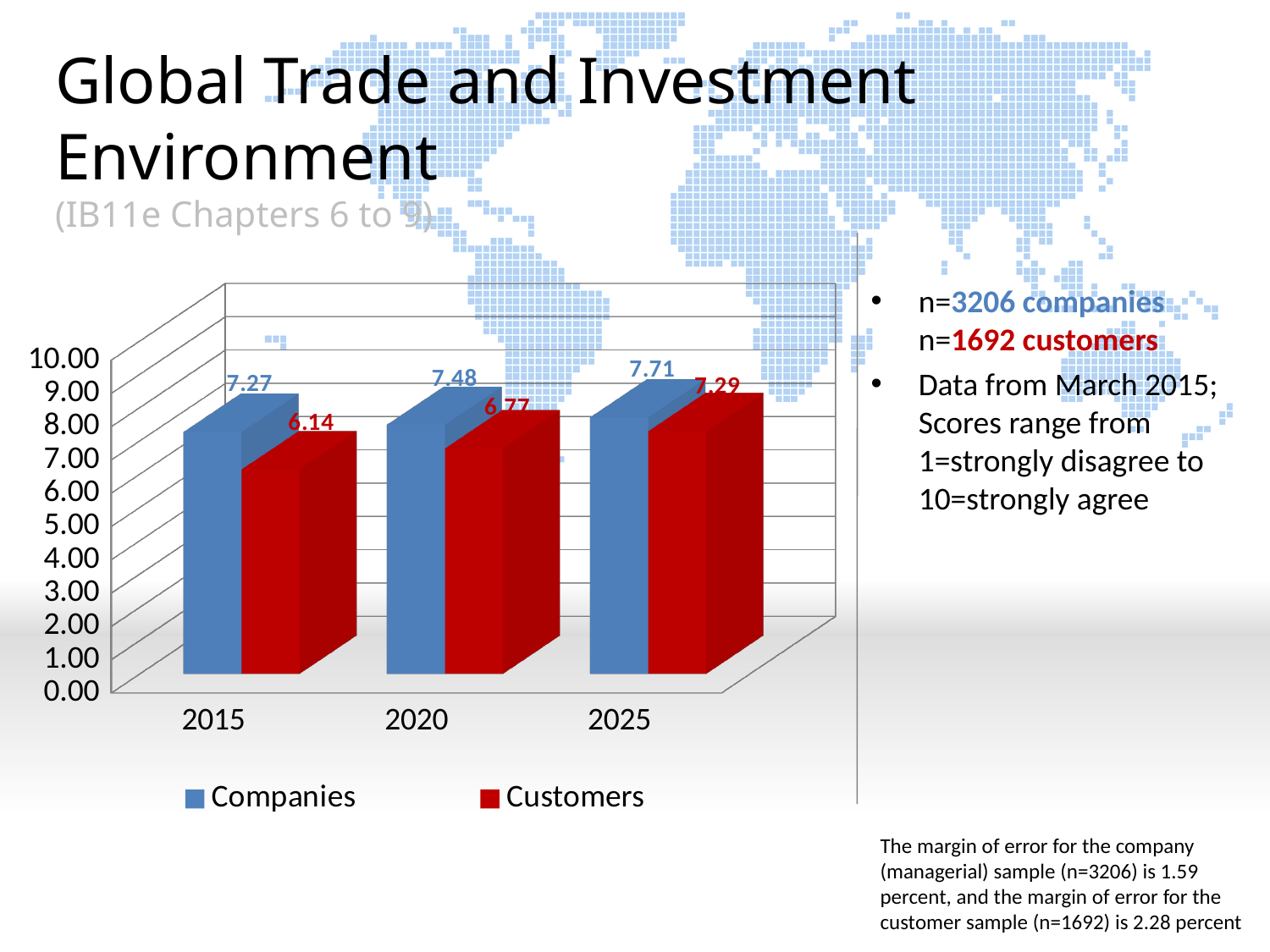
What is the Customers value for 2025? 7.29 Which is larger in 2025, the Companies value or the Customers value? Companies Which year has the highest Companies value? 2025 Which year has the lowest Customers value? 2015 What kind of chart is shown on the slide? Bar chart What is the Companies value for 2015? 7.27 What is the difference between the Companies and Customers values in 2015? 1.13 How many years are shown on the x axis? 3 What is the Customers value for 2020? 6.77 How many series does the legend list? 2 Which colour represents the Customers series? Red Do the Customers values rise or fall from 2015 to 2025? Rise